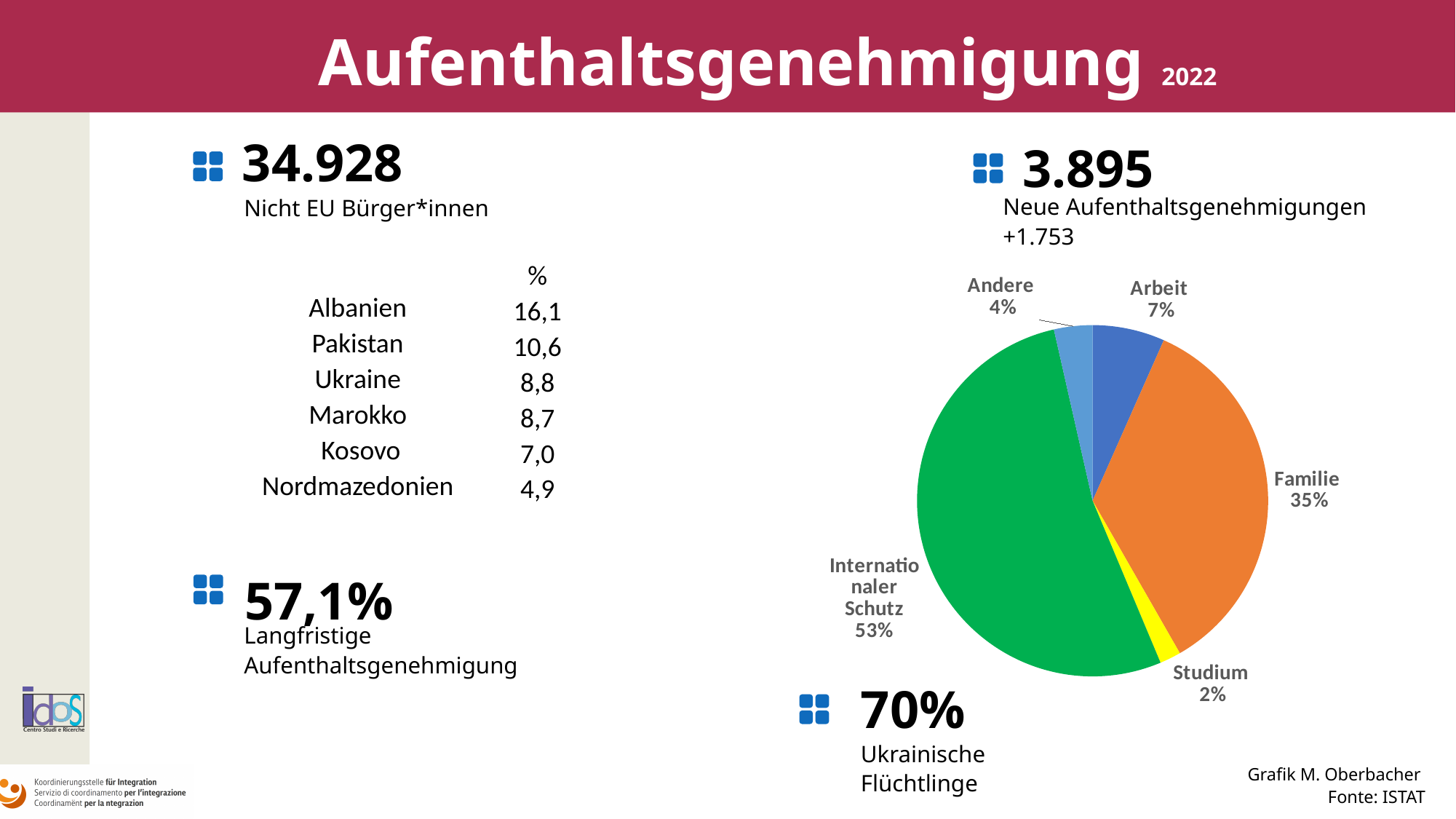
In the pie chart, what is the difference in percentage points between Internationaler Schutz and Familie? 18 What colour is the Familie slice in the pie chart? orange Which slice of the pie chart is the largest? Internationaler Schutz What kind of chart is shown on the slide? pie chart In the pie chart, what share is labelled for Familie? 35% How many slices does the pie chart have? 5 In the pie chart, what share is labelled for Arbeit? 7% In the pie chart, what share is labelled for Internationaler Schutz? 53% In the pie chart, what share is labelled for Andere? 4% In the pie chart, which is larger: Familie or Arbeit? Familie In the pie chart, what share is labelled for Studium? 2% Which slice of the pie chart is the smallest? Studium